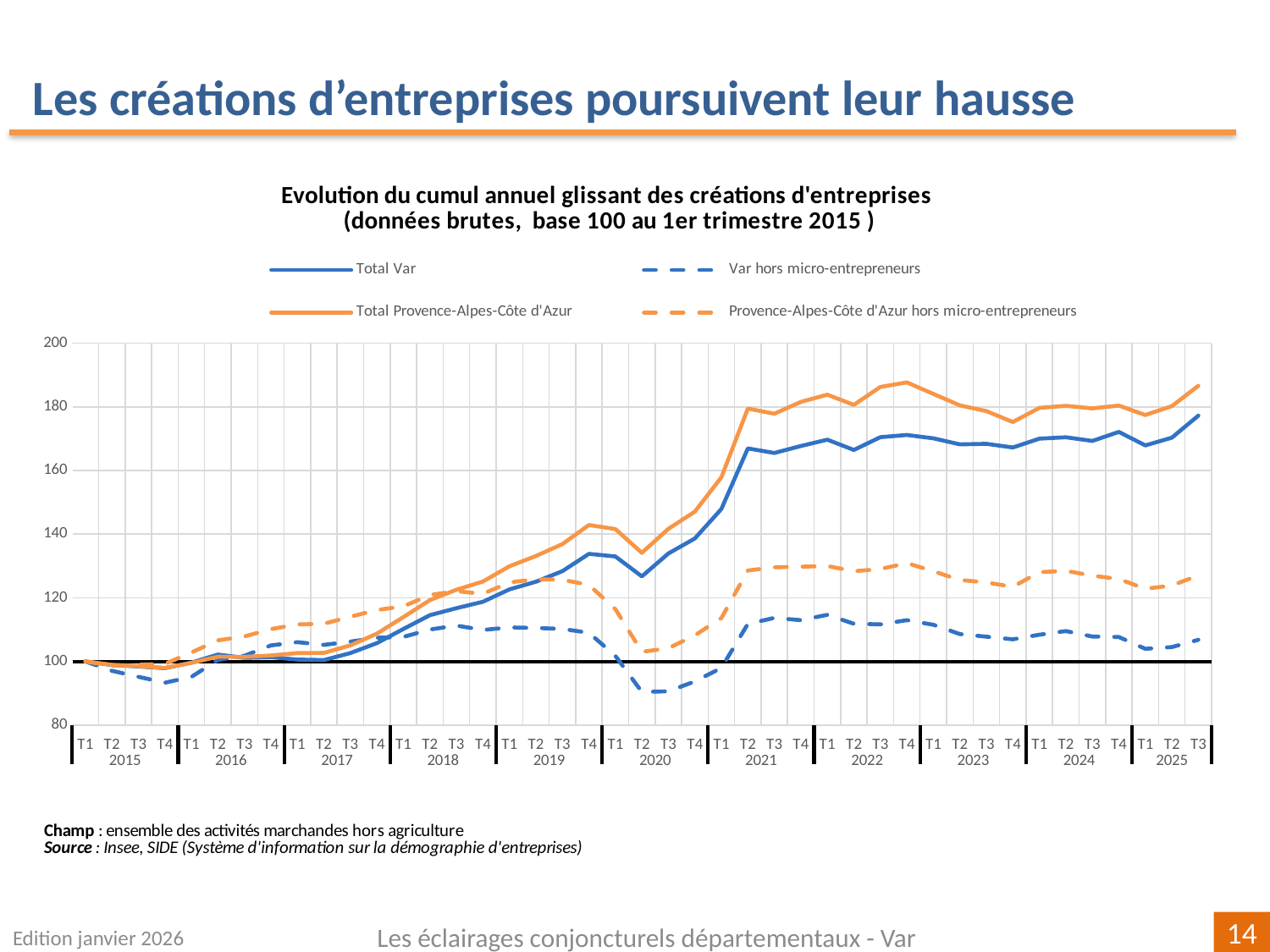
At T3 2025, which is higher: Total Var or Total Provence-Alpes-Côte d'Azur? Total Provence-Alpes-Côte d'Azur Does the Total Var series rise or fall between T1 2020 and T2 2020? fall How many years are shown on the x axis? 11 Is the value for Total Var at T2 2021 greater or less than 160? greater Is the value for Var hors micro-entrepreneurs at T2 2020 greater or less than 100? less What kind of chart is shown on the slide? line chart What is the value of the Total Var series at T1 2015? 100 Which two series are drawn with dashed lines? Var hors micro-entrepreneurs and Provence-Alpes-Côte d'Azur hors micro-entrepreneurs Which series has the lowest value at T2 2020? Var hors micro-entrepreneurs How many series does the legend list? 4 Is the value for Total Provence-Alpes-Côte d'Azur at T4 2022 greater or less than 180? greater Which series has the highest value at T3 2025? Total Provence-Alpes-Côte d'Azur